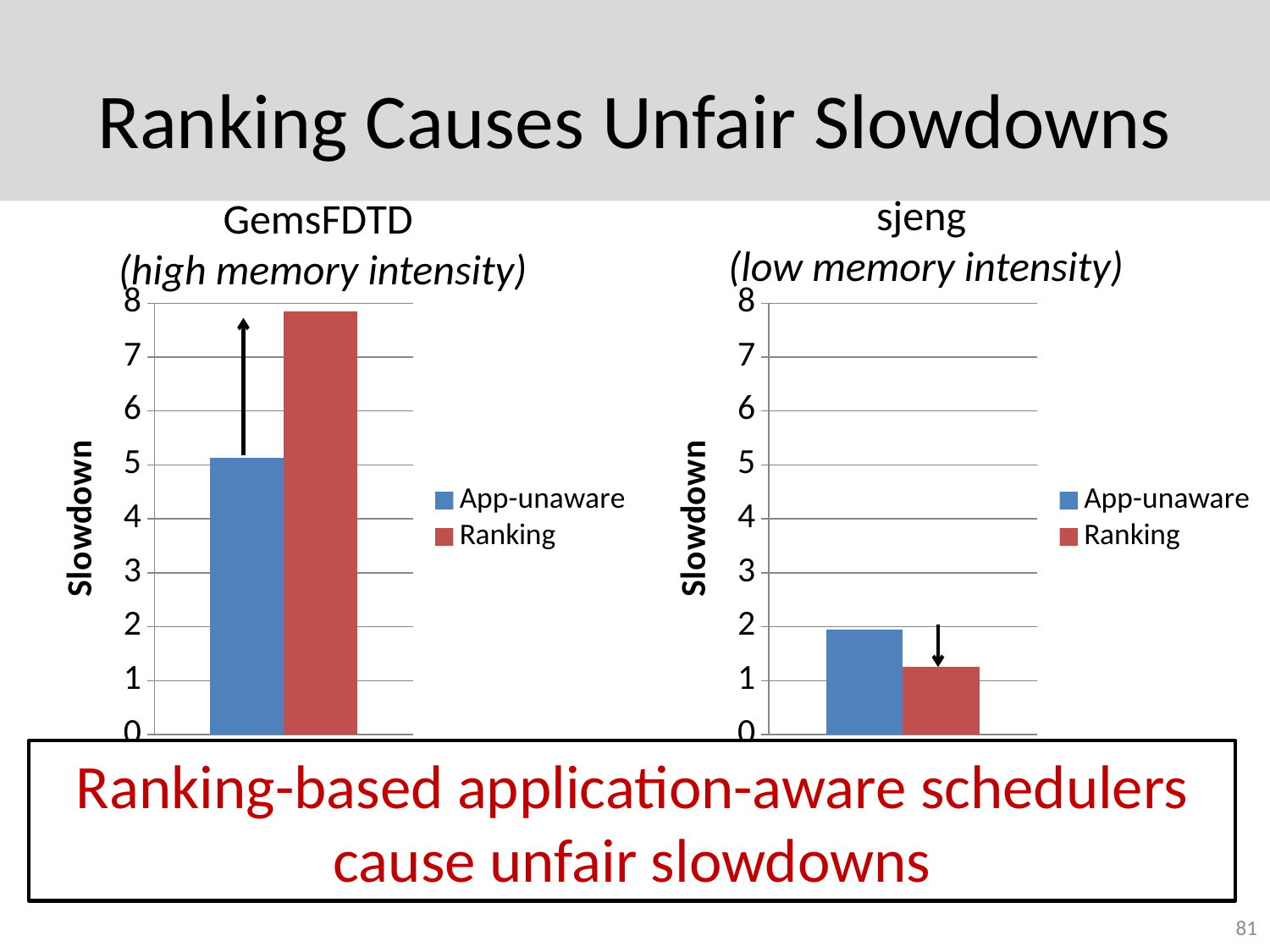
In the GemsFDTD chart, is the slowdown for App-unaware greater or less than 6? less In the sjeng chart, how many series does the legend list? 2 In the sjeng chart, how many bars are plotted? 2 In the GemsFDTD chart, what kind of chart is shown? bar chart In the GemsFDTD chart, how many series does the legend list? 2 In the sjeng chart, what is the label on the vertical axis? Slowdown In the GemsFDTD chart, is the slowdown for Ranking greater or less than 7? greater In the sjeng chart, is the slowdown for App-unaware greater or less than 1? greater In the GemsFDTD chart, which series has the larger slowdown, App-unaware or Ranking? Ranking In the sjeng chart, which series has the larger slowdown, App-unaware or Ranking? App-unaware In the GemsFDTD chart, what colour is the Ranking bar? red